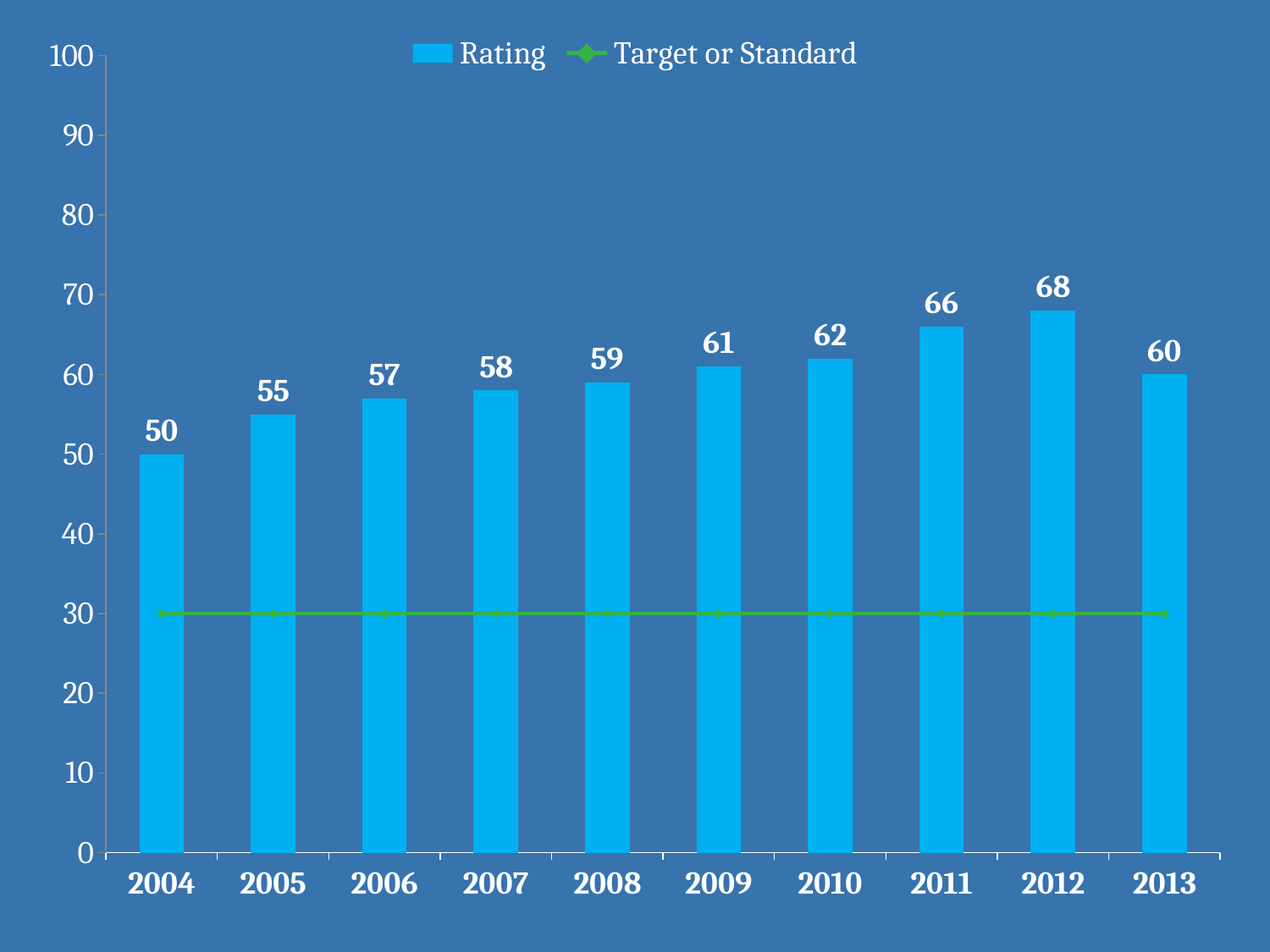
Which year has a larger Rating, 2011 or 2013? 2011 Which year has the lowest Rating? 2004 What colour are the Rating bars? light blue How many series does the legend list? 2 What is the Rating value for 2013? 60 What is the difference between the Rating for 2012 and the Rating for 2004? 18 Is the Target or Standard line greater or less than 40? less What kind of chart is used to show the Rating series? bar chart Does the Rating rise or fall from 2004 to 2012? rise How many years are shown on the x axis? 10 What is the Rating value for 2008? 59 Which year has the highest Rating? 2012